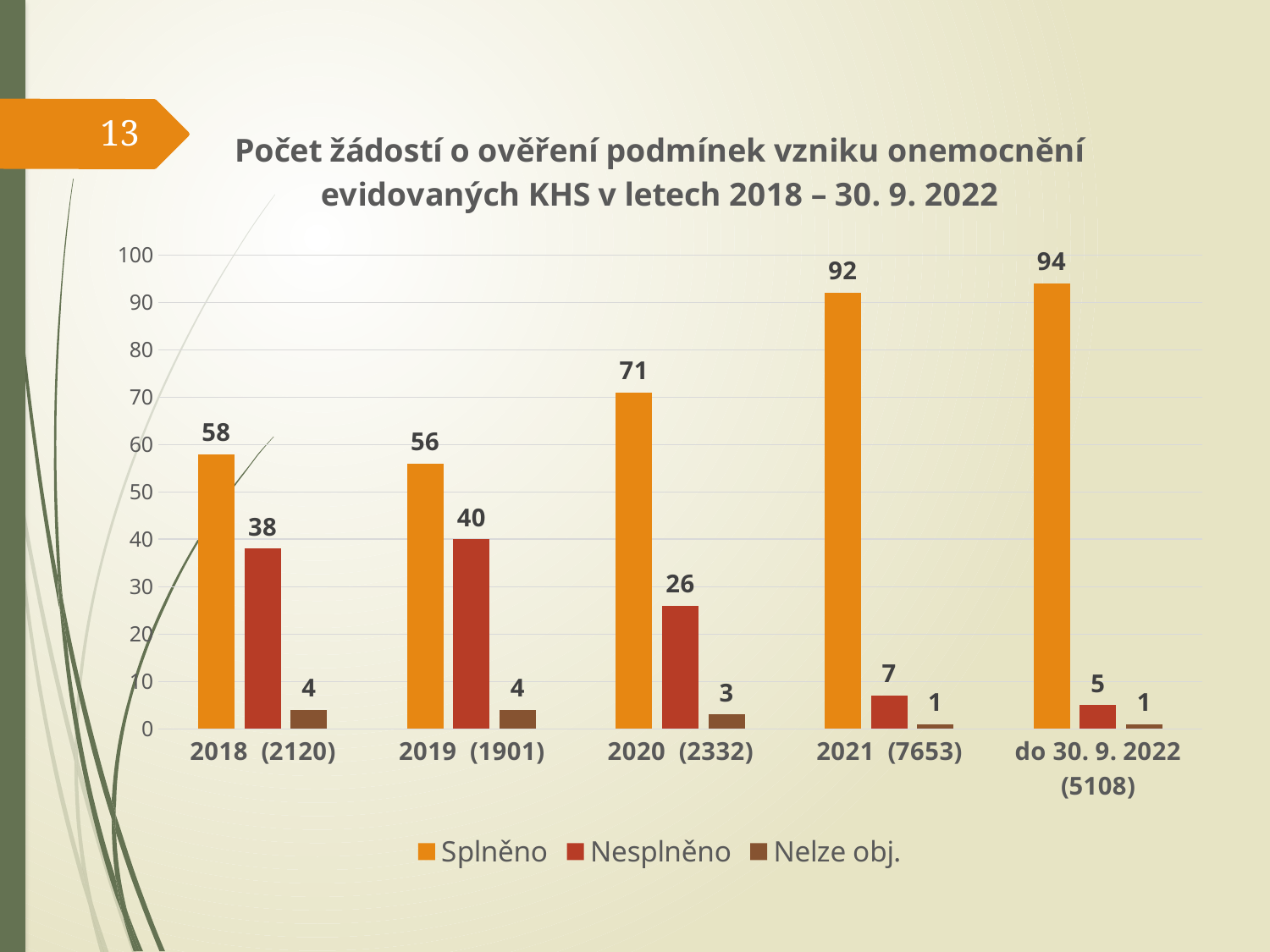
Do the Nesplněno values generally rise or fall from 2019 (1901) to do 30. 9. 2022 (5108)? fall What is the value for Splněno in 2018 (2120)? 58 How many categories are shown on the x axis? 5 Which series is shown in orange in the legend? Splněno What is the difference between the Splněno values for 2021 (7653) and 2020 (2332)? 21 What kind of chart is shown on the slide? bar chart What is the value for Nelze obj. in 2020 (2332)? 3 Which is larger: Nesplněno in 2018 (2120) or Nesplněno in 2019 (1901)? 2019 (1901) Which category has the lowest Nesplněno value? do 30. 9. 2022 (5108) Which category has the highest Splněno value? do 30. 9. 2022 (5108) What is the value for Nesplněno in 2019 (1901)? 40 How many series does the legend list? 3